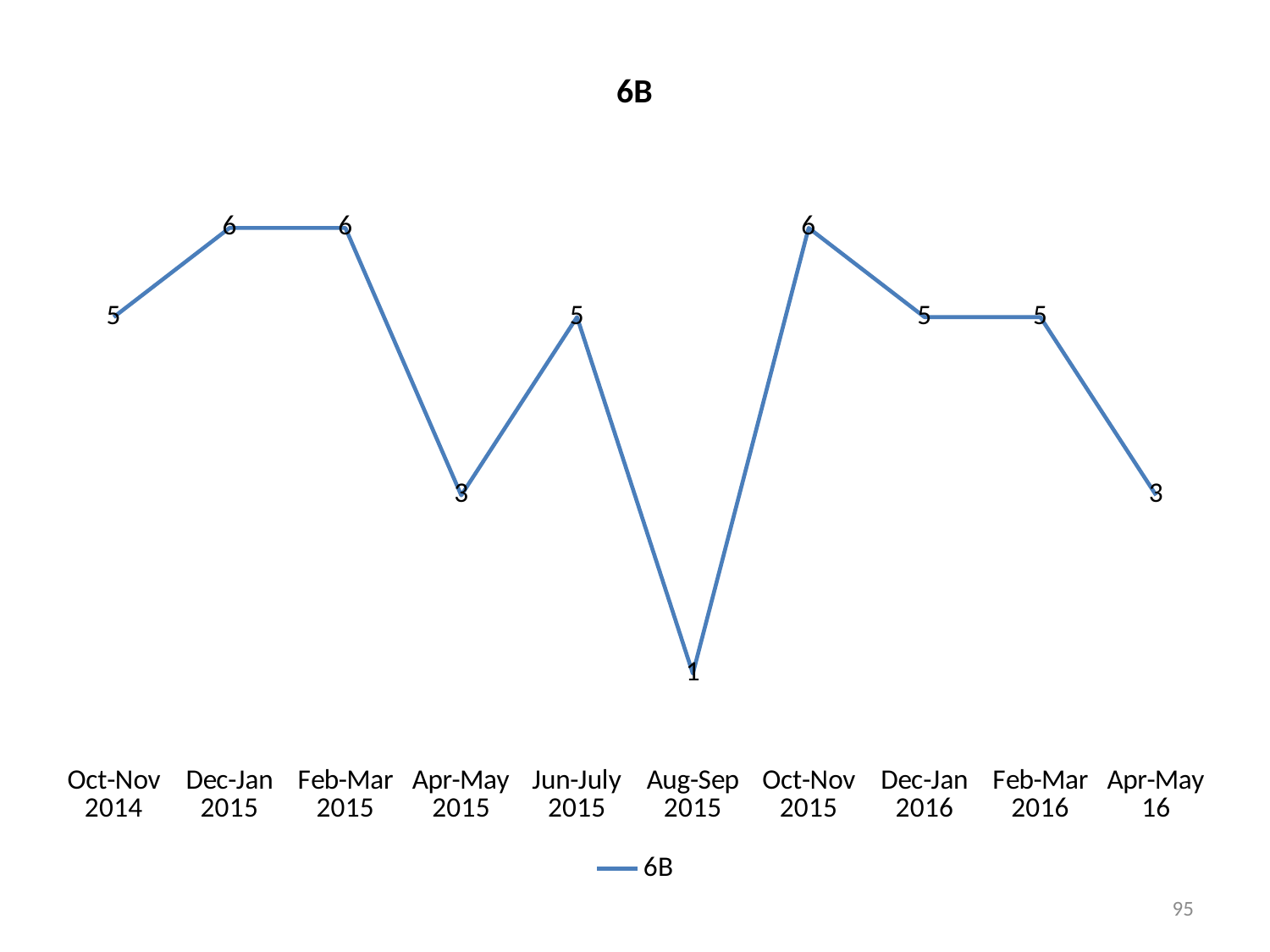
What is the title of the chart? 6B Which period has the lowest value? Aug-Sep 2015 What is the value for Aug-Sep 2015? 1 Which is larger, the value for Jun-July 2015 or the value for Apr-May 2015? Jun-July 2015 Does the value rise or fall from Feb-Mar 2016 to Apr-May 16? fall What is the difference between the values for Oct-Nov 2015 and Aug-Sep 2015? 5 What is the difference between the values for Dec-Jan 2015 and Apr-May 2015? 3 How many periods are plotted on the x axis? 10 What is the value for Apr-May 16? 3 What is the value for Oct-Nov 2014? 5 What kind of chart is shown? line chart How many series does the legend list? 1